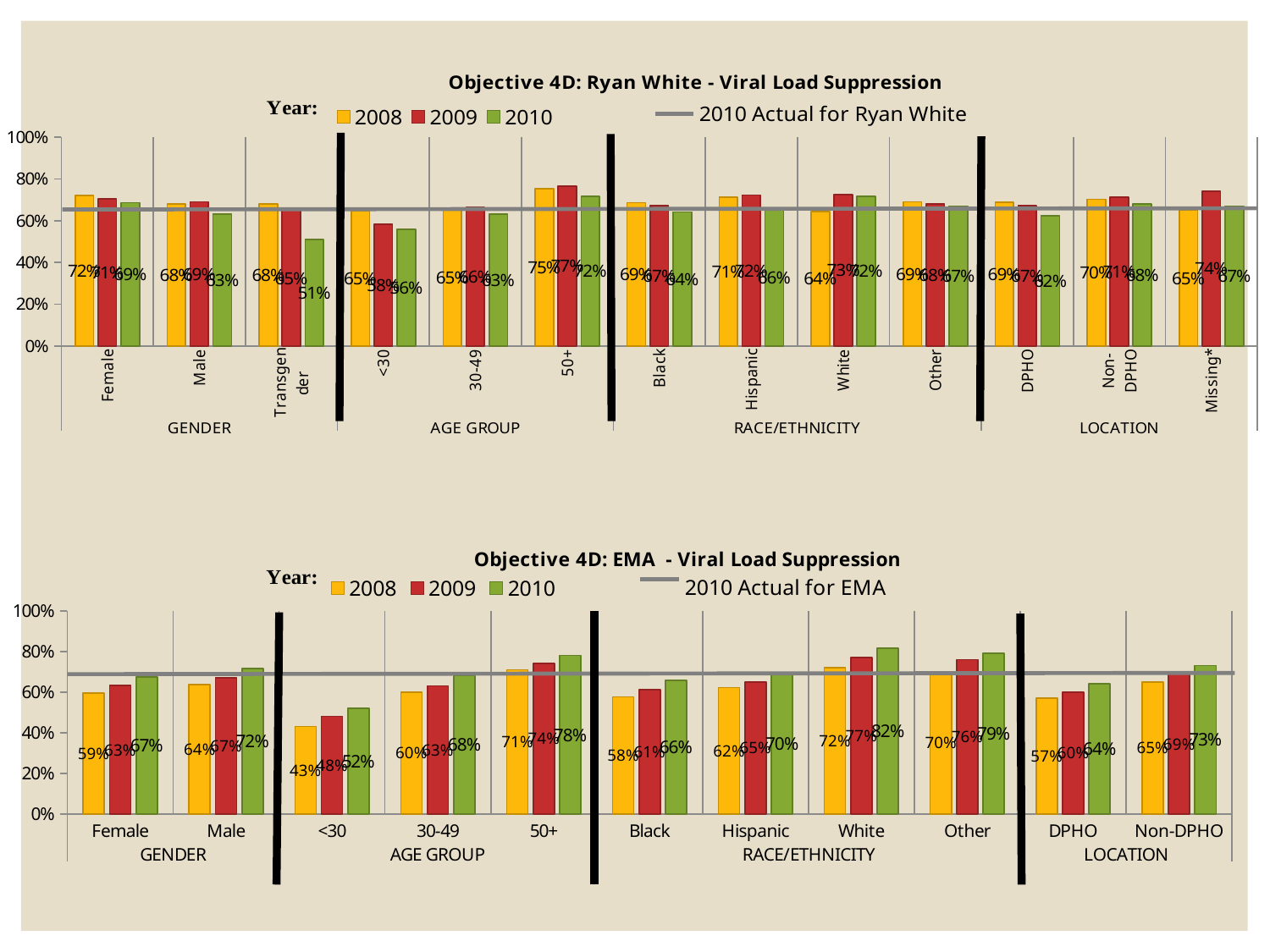
In the EMA chart, is the 2010 value for DPHO larger or smaller than the 2010 value for Non-DPHO? smaller In the EMA chart, what is the difference between the 2010 and 2008 values for Male? 8% In the Ryan White chart, what is the 2010 value for Transgender? 51% In the EMA chart, what is the 2010 value for White? 82% In the EMA chart, which category has the highest 2010 value? White In the EMA chart, what is the 2008 value for the <30 age group? 43% What type of chart is the Ryan White chart? bar chart In the EMA chart, which category has the lowest 2008 value? <30 What is the title of the bottom chart? Objective 4D: EMA - Viral Load Suppression In the EMA chart, do the values for Female rise or fall from 2008 to 2010? rise In the Ryan White chart, what is the 2008 value for the 50+ age group? 75% How many series does the legend of the EMA chart list, including the line? 4